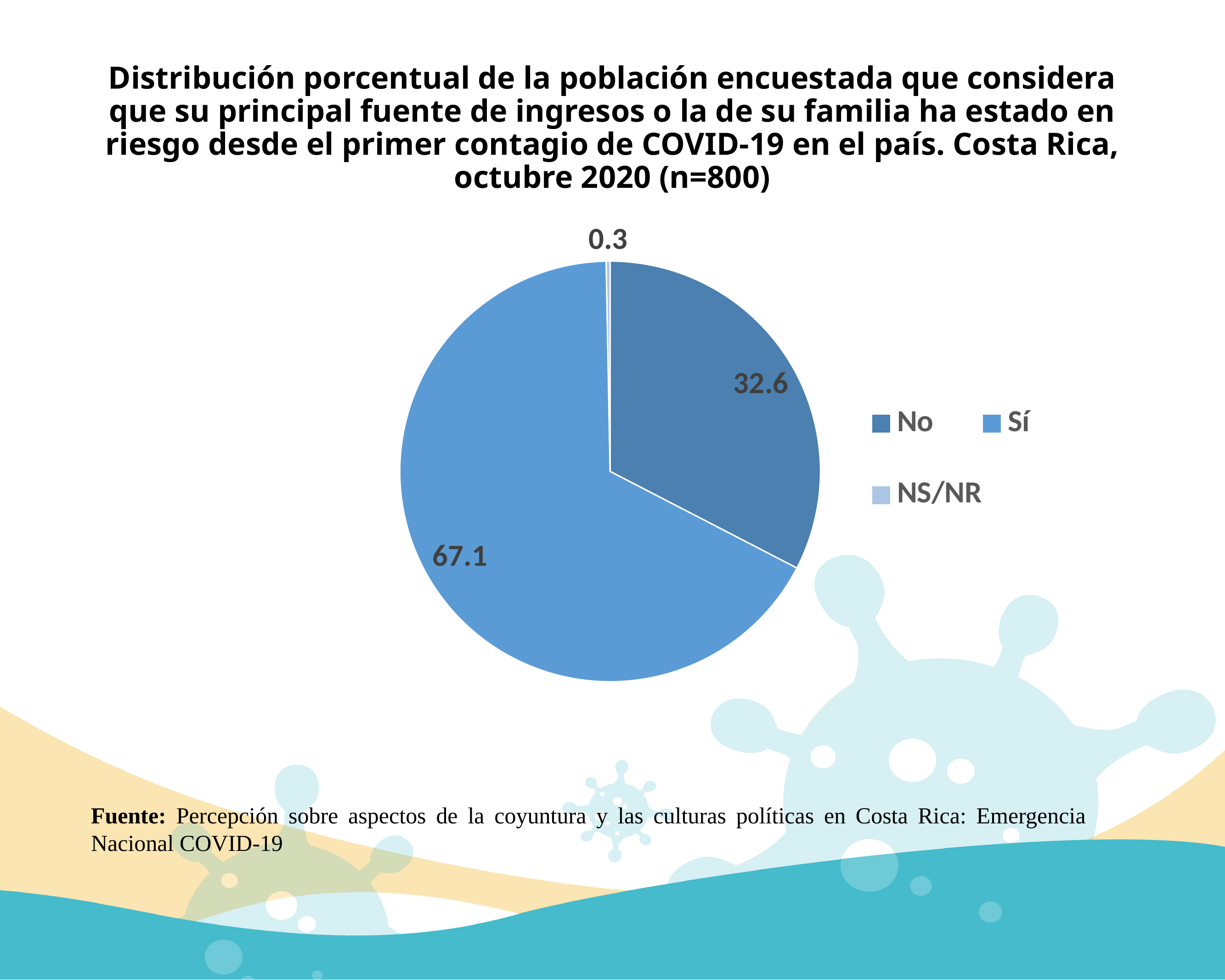
Which is larger, the 'No' slice or the 'Sí' slice? Sí What is the sample size (n) stated in the chart title? 800 What is the value for the 'No' slice? 32.6 How many entries does the legend list? 3 Which category has the largest slice? Sí How many categories does the pie chart show? 3 What is the value for the 'NS/NR' slice? 0.3 What is the value for the 'Sí' slice? 67.1 What kind of chart is shown on the slide? pie chart What is the difference between the 'Sí' and 'No' values? 34.5 Which category has the smallest slice? NS/NR What is the difference between the 'No' and 'NS/NR' values? 32.3